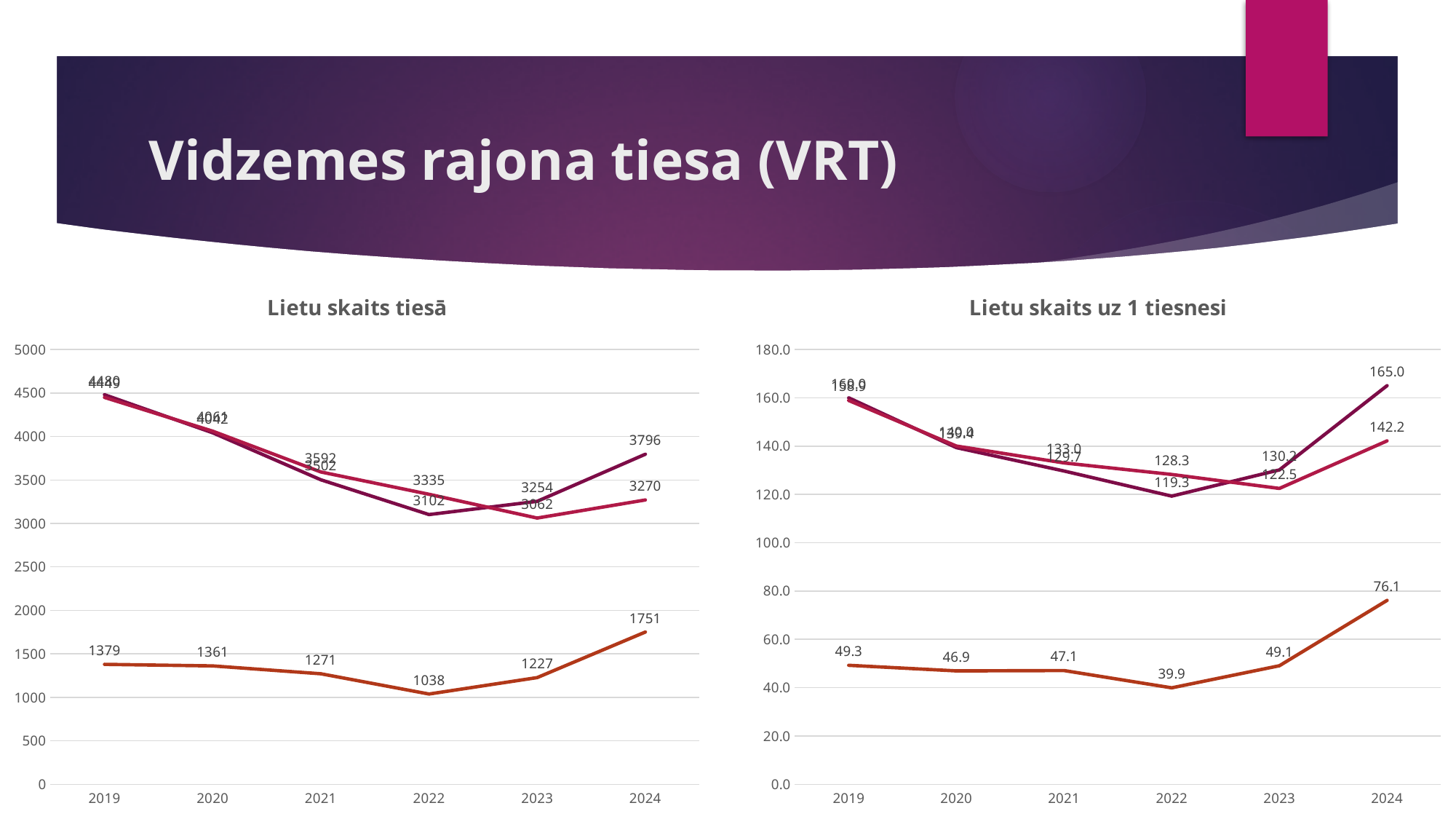
In the chart titled "Lietu skaits uz 1 tiesnesi", what is the value of the orange line in 2024? 76.1 In the chart titled "Lietu skaits tiesā", in which year is the orange line at its lowest? 2022 In the chart titled "Lietu skaits uz 1 tiesnesi", what is the highest value shown for 2024? 165.0 How many years are shown on the x axis of the chart titled "Lietu skaits tiesā"? 6 In the chart titled "Lietu skaits uz 1 tiesnesi", is the orange line's value in 2022 greater or less than 40.0? less In the chart titled "Lietu skaits tiesā", what is the highest value shown for 2024? 3796 In the chart titled "Lietu skaits uz 1 tiesnesi", in which year does the orange line reach its highest value? 2024 What type of chart is the chart titled "Lietu skaits uz 1 tiesnesi"? Line chart In the chart titled "Lietu skaits tiesā", what is the value of the orange line in 2024? 1751 In the chart titled "Lietu skaits uz 1 tiesnesi", what is the value of the orange line in 2022? 39.9 In the chart titled "Lietu skaits tiesā", what is the difference between the orange line's values in 2024 and 2023? 524 In the chart titled "Lietu skaits tiesā", what is the value of the orange line in 2022? 1038